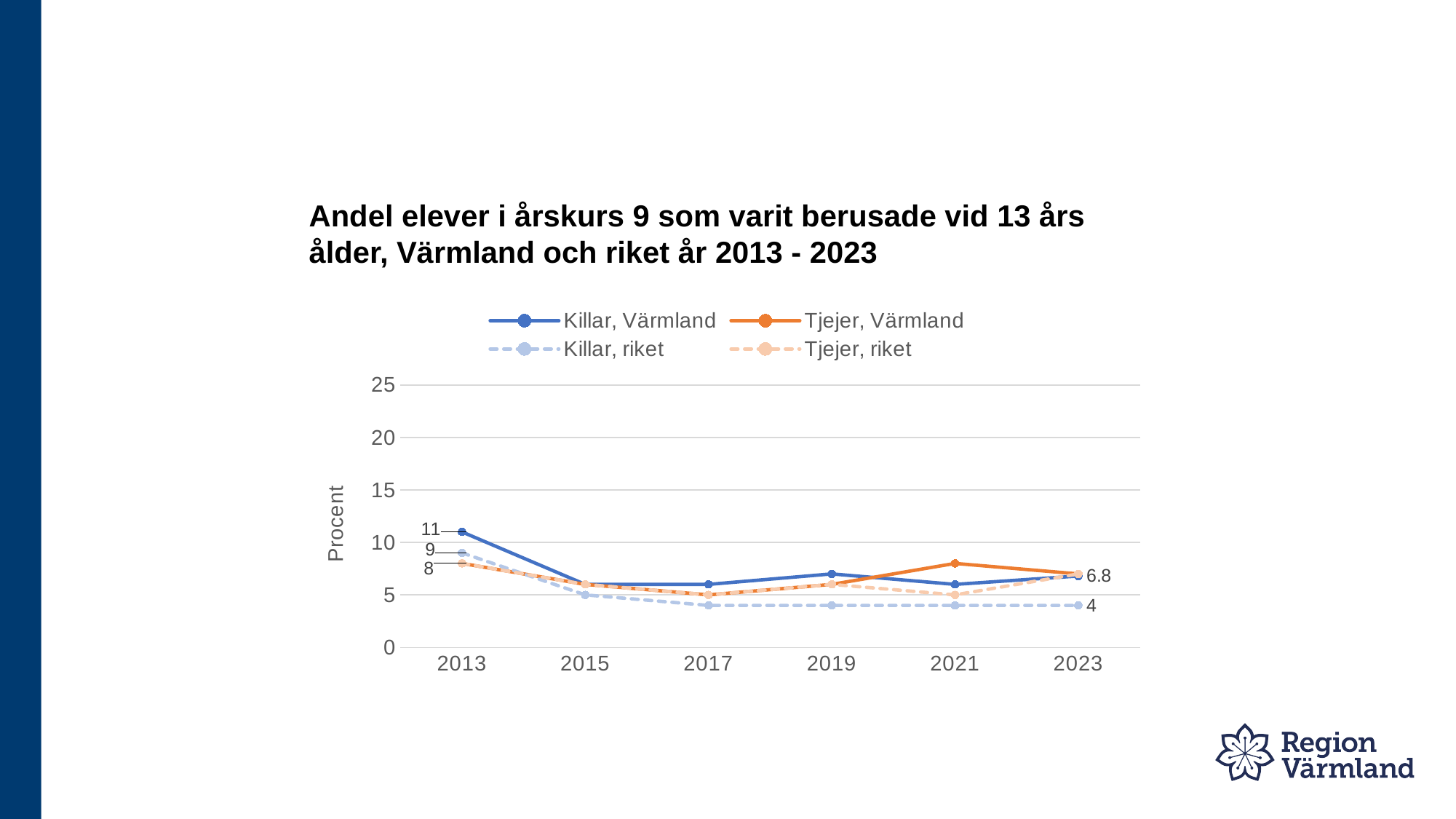
How many years are shown on the x axis? 6 What is the value for Killar, riket in 2013? 9 Which series has the highest value in 2013? Killar, Värmland What is the difference between Killar, Värmland and Killar, riket in 2013? 2 How many series does the legend list? 4 What kind of chart is shown on the slide? line chart What is the value for Killar, riket in 2023? 4 Is the value for Tjejer, Värmland in 2021 greater or less than 10? less Which series has the lowest value in 2023? Killar, riket What is the label on the y axis? Procent Does the Killar, riket line rise or fall from 2013 to 2023? fall What is the value for Killar, Värmland in 2013? 11